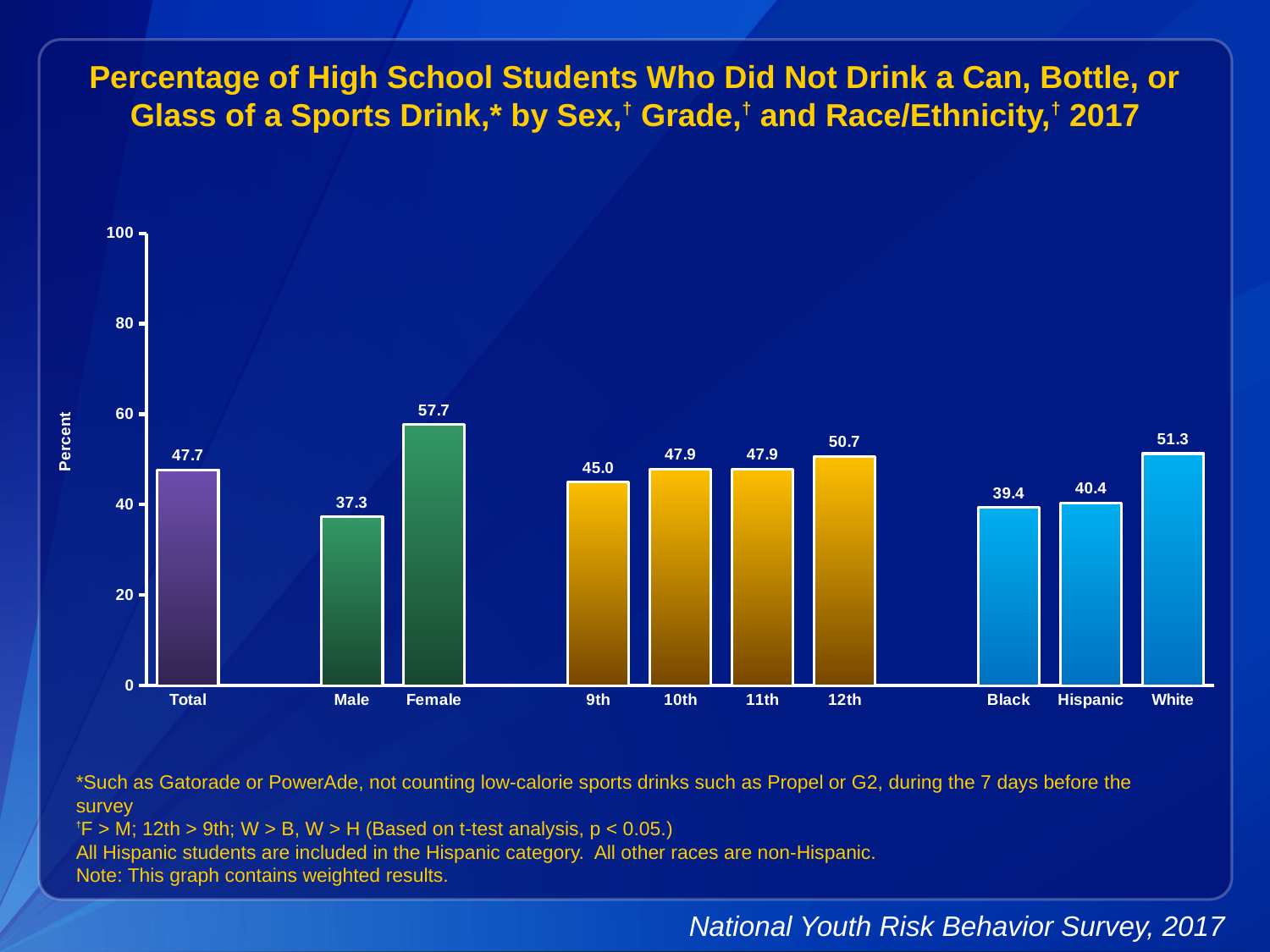
What is the difference between the Female and Male values? 20.4 Which category has the lowest value? Male What is the value for Female? 57.7 What is the label of the y axis? Percent Which is larger, the value for 12th or the value for 9th? 12th Which category has the highest value? Female What kind of chart is this? bar chart How many bars are shown in the chart? 10 What is the value for Hispanic? 40.4 Do the values rise or fall from 9th grade to 12th grade? rise Is the value for White greater or less than 40? greater What is the value for Total? 47.7